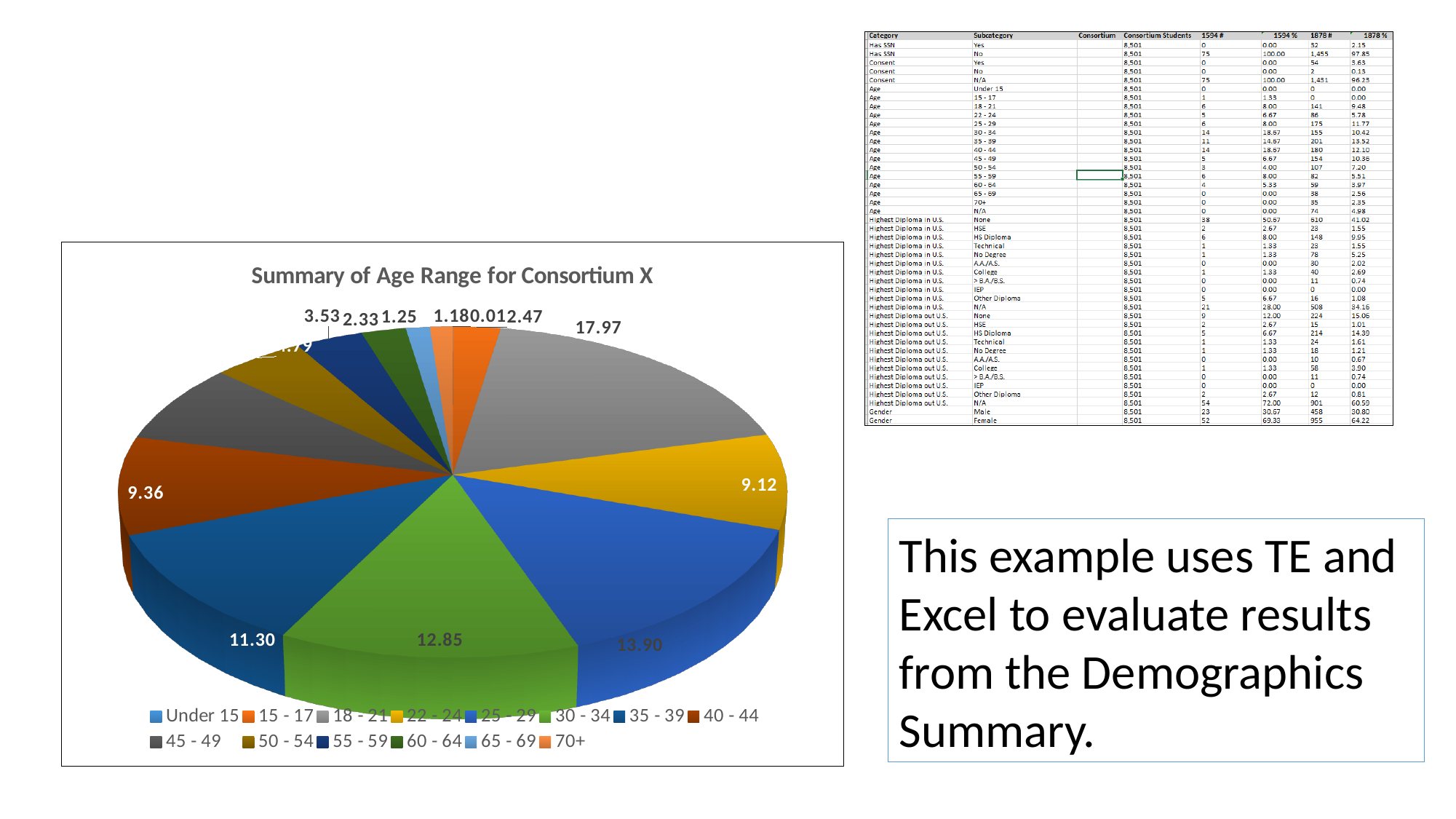
What is the title of the chart? Summary of Age Range for Consortium X Which age range has the largest slice of the pie? 18 - 21 How many age categories does the chart's legend list? 14 What is the value shown for the 30 - 34 slice? 12.85 What is the value shown for the 22 - 24 slice? 9.12 What is the value shown for the 25 - 29 slice? 13.90 What is the difference between the values for 18 - 21 and 25 - 29? 4.07 Which slice is larger, 25 - 29 or 30 - 34? 25 - 29 What is the value shown for the 40 - 44 slice? 9.36 What is the value shown for the 18 - 21 slice? 17.97 What is the value shown for the 35 - 39 slice? 11.30 What kind of chart is shown on the slide? pie chart